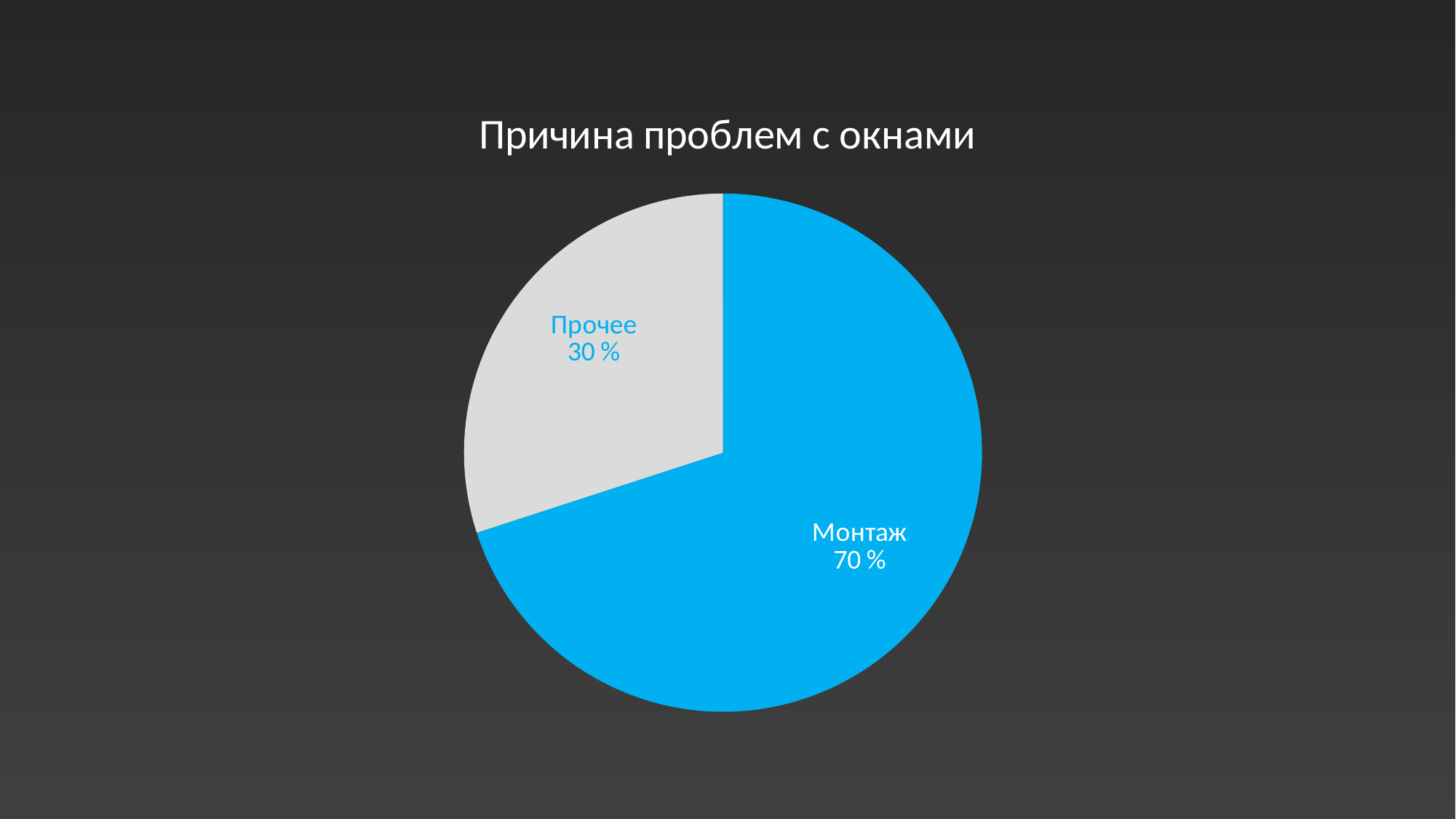
Which is larger, the slice for Монтаж or the slice for Прочее? Монтаж How many slices does the pie chart have? 2 Which category has the smallest slice of the pie? Прочее What share of the pie does Монтаж represent? 70 % What colour is the slice for Монтаж? Blue Which category has the largest slice of the pie? Монтаж What is the difference between the values for Монтаж and Прочее? 40 % What is the value shown for Монтаж? 70 % What is the title of the chart? Причина проблем с окнами What is the value shown for Прочее? 30 % What kind of chart is shown on the slide? Pie chart